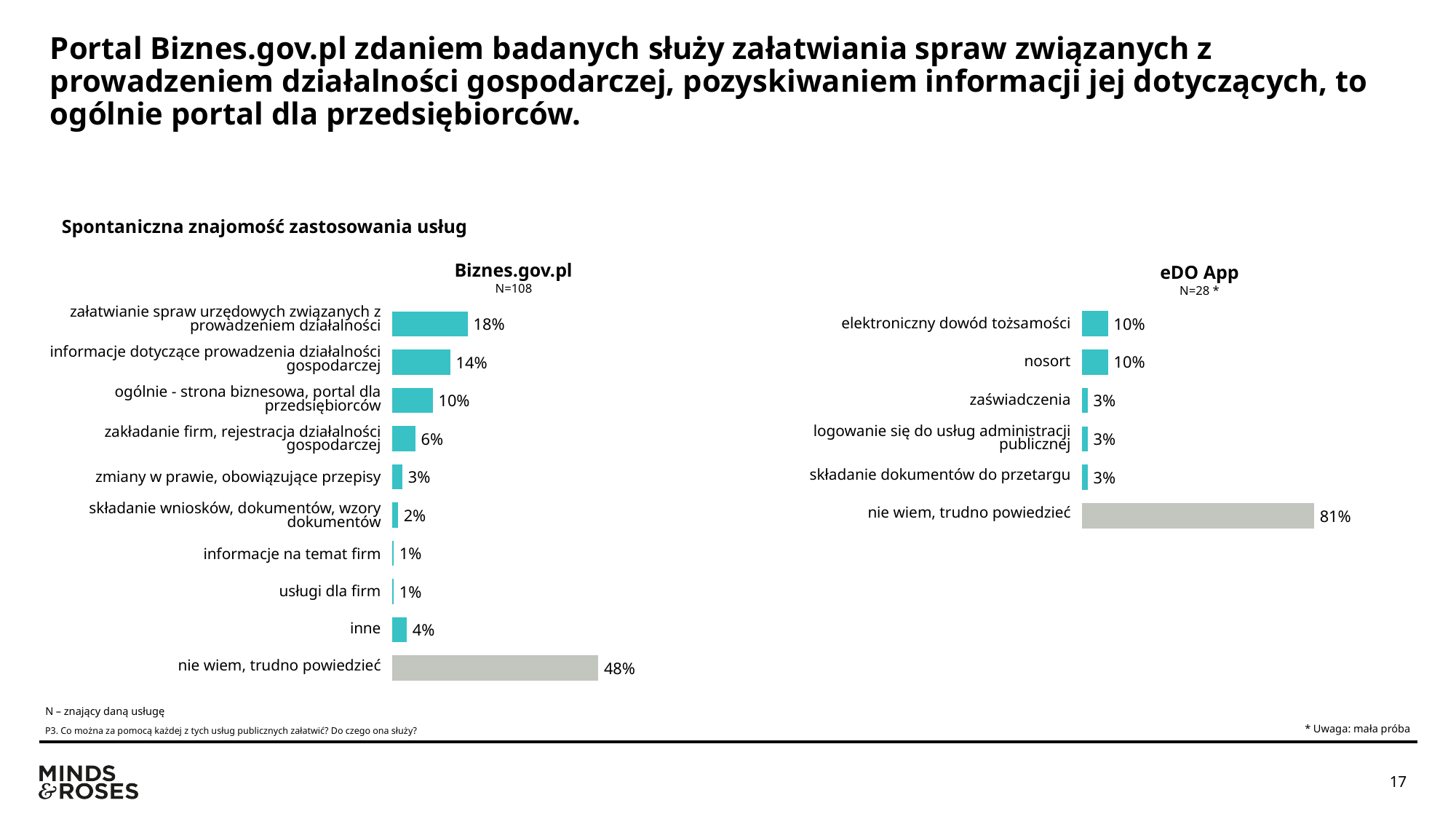
In the eDO App chart, what is the difference between "nie wiem, trudno powiedzieć" and "elektroniczny dowód tożsamości"? 71% In the eDO App chart, what is the value for "zaświadczenia"? 3% How many categories are shown in the Biznes.gov.pl chart? 10 In the Biznes.gov.pl chart, what is the value for "informacje dotyczące prowadzenia działalności gospodarczej"? 14% In the Biznes.gov.pl chart, what is the difference between "załatwianie spraw urzędowych związanych z prowadzeniem działalności" and "zakładanie firm, rejestracja działalności gospodarczej"? 12% What type of chart is the Biznes.gov.pl chart? bar chart How many categories are shown in the eDO App chart? 6 Which is larger: "inne" in the Biznes.gov.pl chart or "zmiany w prawie, obowiązujące przepisy" in the Biznes.gov.pl chart? inne In the Biznes.gov.pl chart, which category has the highest value among the teal bars? załatwianie spraw urzędowych związanych z prowadzeniem działalności In the Biznes.gov.pl chart, what is the value for "nie wiem, trudno powiedzieć"? 48% What is the sample size (N) shown under the eDO App chart title? N=28 * In the eDO App chart, which category has the highest value? nie wiem, trudno powiedzieć